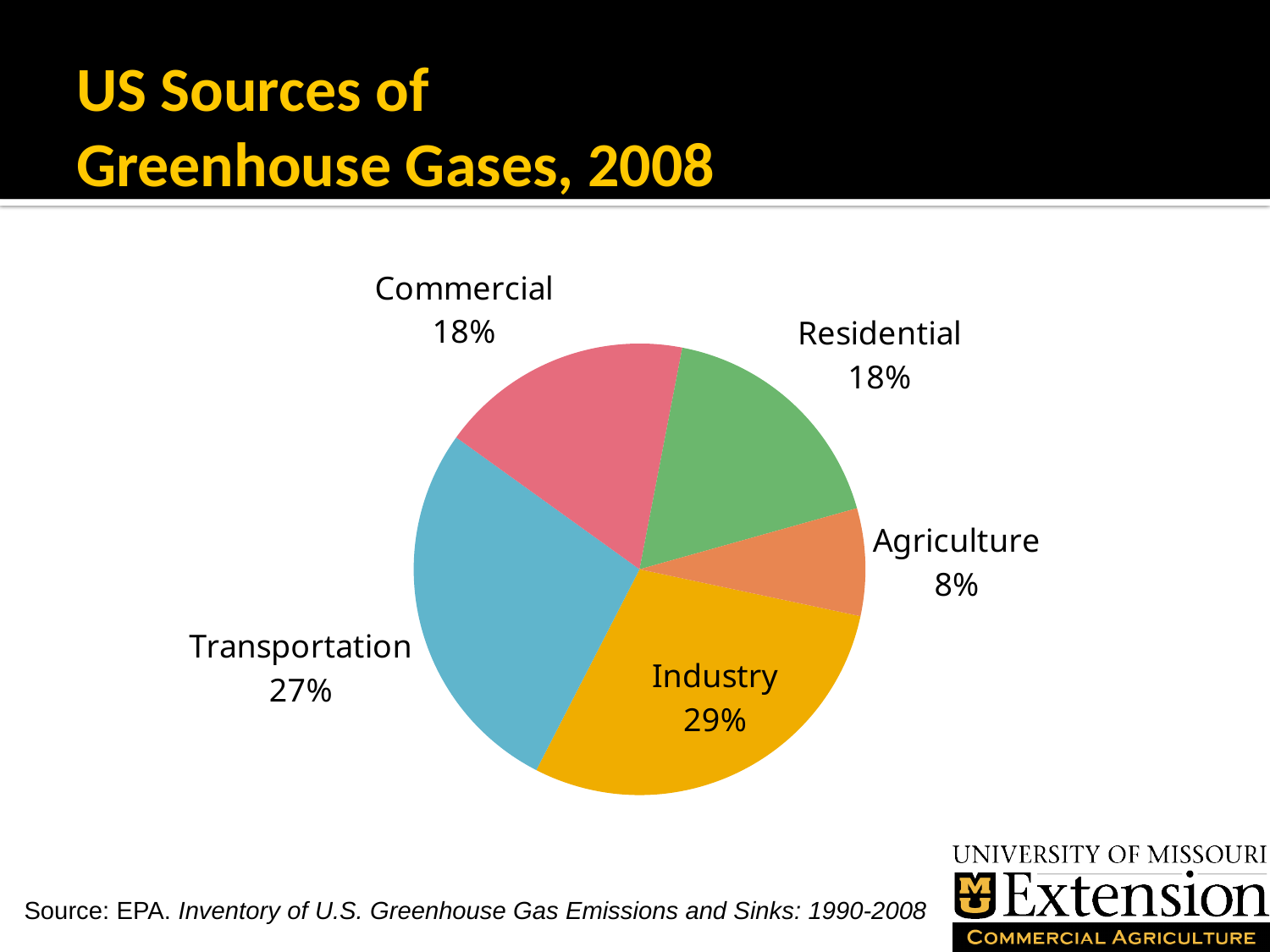
How many sources (slices) are shown in the pie chart? 5 What is the difference in percentage points between Industry and Transportation? 2 What kind of chart is shown on the slide? pie chart What is the title of the slide containing the chart? US Sources of Greenhouse Gases, 2008 Which source has the smallest slice of the pie? Agriculture Which source has the largest slice of the pie? Industry What percentage is shown for Agriculture? 8% Which is larger, the share for Transportation or the share for Residential? Transportation What is the difference in percentage points between Commercial and Agriculture? 10 What is the value shown for Transportation? 27% What share of US greenhouse gas sources does Industry account for? 29% What share is shown for Residential? 18%